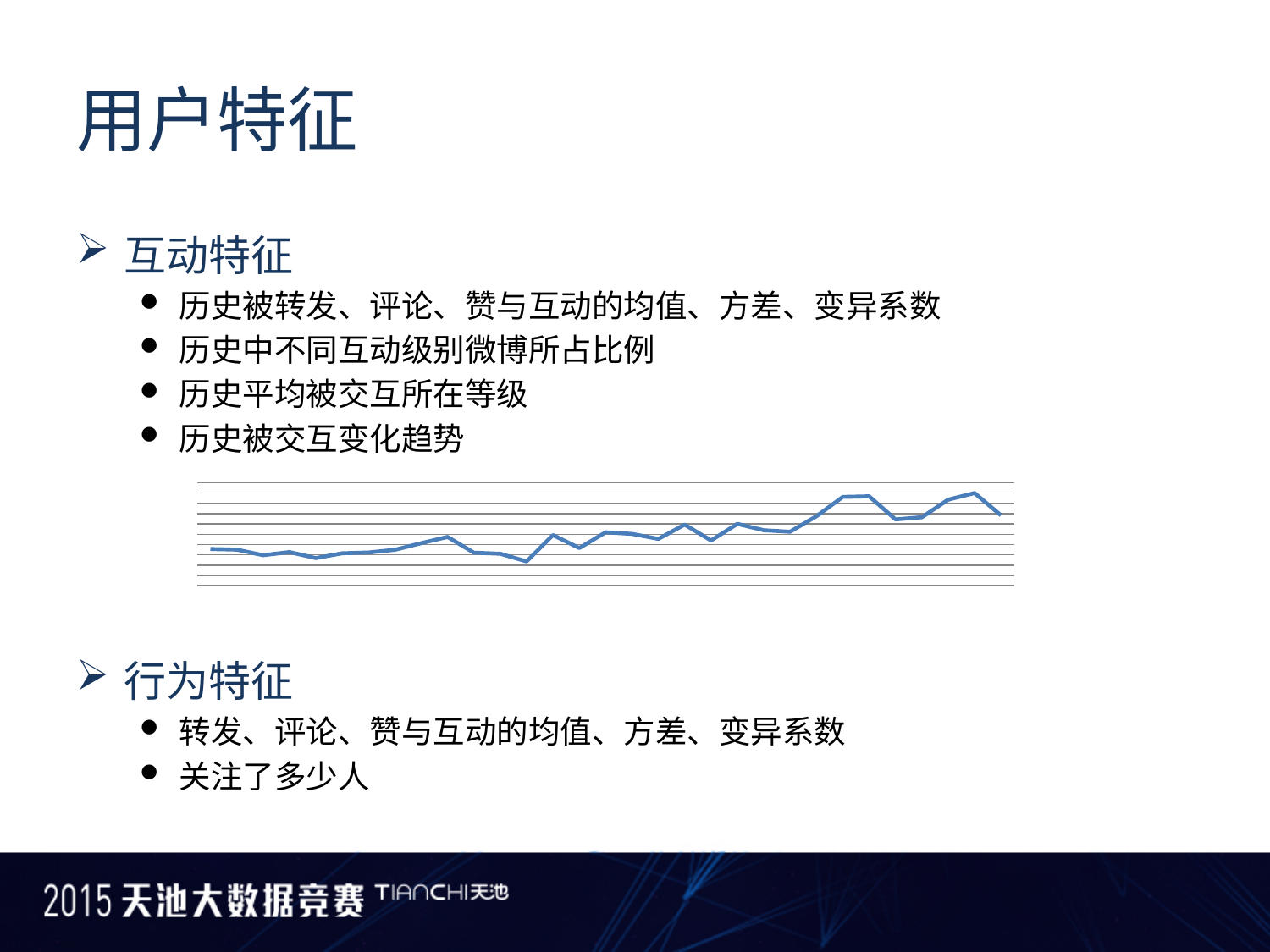
How many lines are plotted in the chart? 1 What colour is the line in the chart? blue Does the line chart have a legend? No What kind of chart is shown on the slide? line chart Do the values in the line chart generally rise or fall from left to right? rise